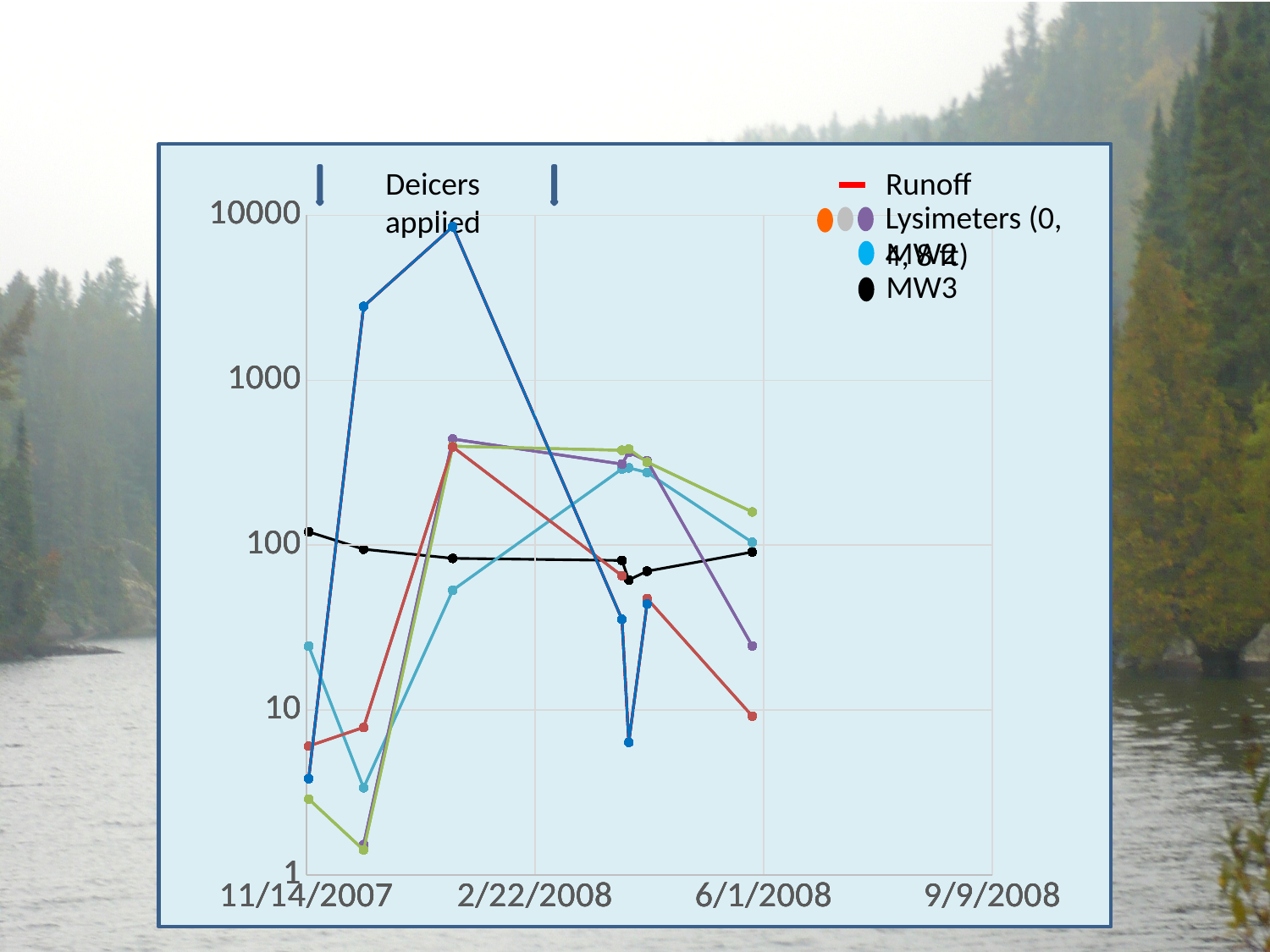
What is the highest value labelled on the y axis? 10000 Is the highest point plotted on the chart greater or less than 1000? greater Is the value of the MW3 series at 2/22/2008 greater or less than 100? less Does the Runoff series rise or fall from its peak to its last point near 6/1/2008? fall What is the first date labelled on the x axis? 11/14/2007 How many date labels are shown on the x axis? 4 Which series in the legend is drawn in black? MW3 Is the first plotted value of the MW3 series (at 11/14/2007) greater or less than 100? greater Does the MW3 series rise or fall between 11/14/2007 and 2/22/2008? fall What annotation text appears at the top of the chart near the arrows? Deicers applied What kind of chart is shown on the slide? line chart